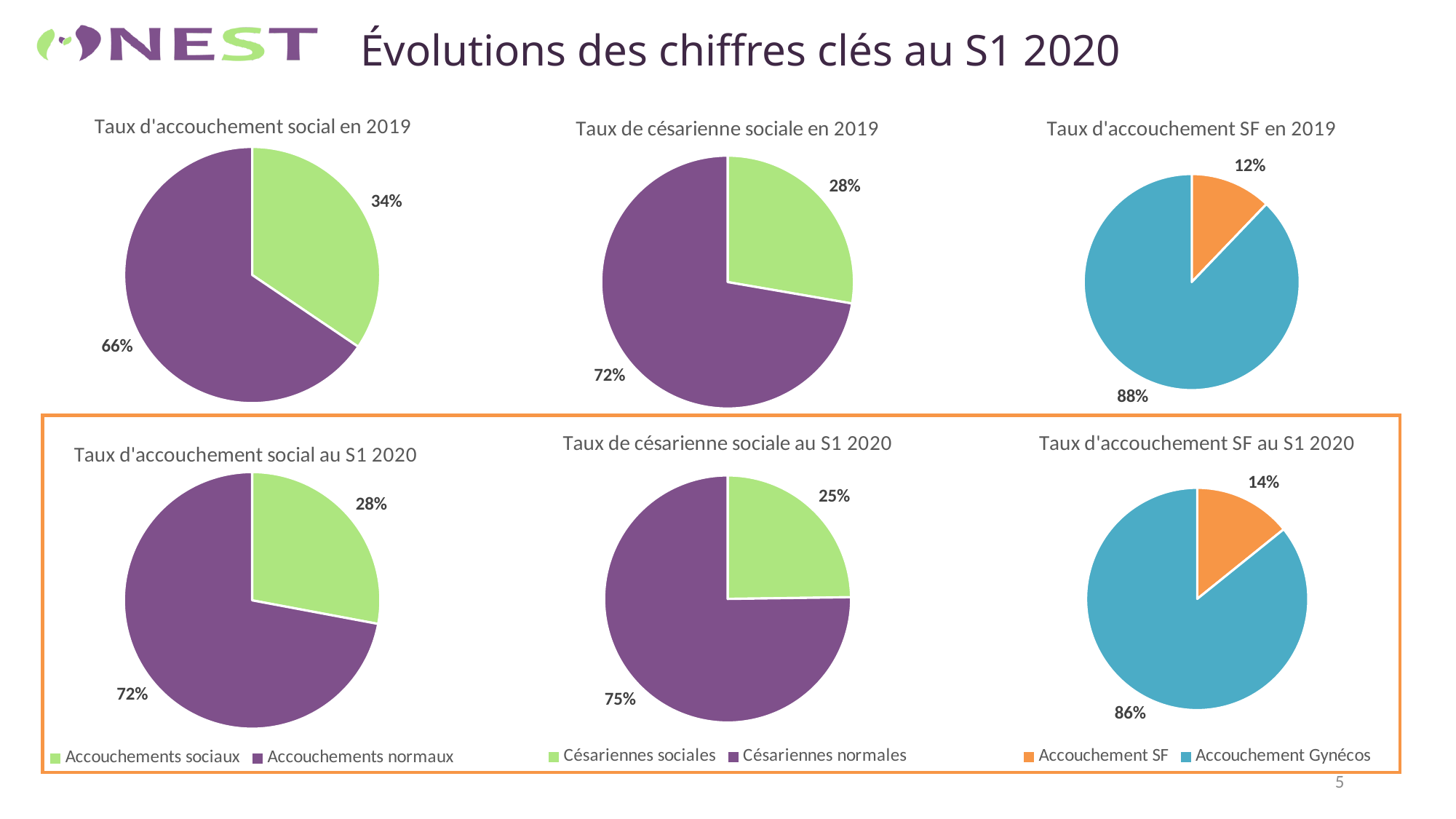
What is the difference between the Accouchements sociaux share in "Taux d'accouchement social en 2019" and in "Taux d'accouchement social au S1 2020"? 6% Which is larger: the Accouchement SF share in "Taux d'accouchement SF en 2019" or in "Taux d'accouchement SF au S1 2020"? Taux d'accouchement SF au S1 2020 What kind of chart is "Taux de césarienne sociale au S1 2020"? Pie chart In the chart titled "Taux d'accouchement SF au S1 2020", which slice is the largest? Accouchement Gynécos In the chart titled "Taux d'accouchement social en 2019", what is the value for Accouchements normaux? 66% In the chart titled "Taux d'accouchement SF en 2019", what share of the pie is Accouchement SF? 12% In the chart titled "Taux de césarienne sociale au S1 2020", what is the value for Césariennes normales? 75% In the chart titled "Taux d'accouchement social au S1 2020", what is the value for Accouchements sociaux? 28% In the chart titled "Taux de césarienne sociale en 2019", which slice is the smallest? Césariennes sociales In the chart titled "Taux d'accouchement SF au S1 2020", what is the value for Accouchement Gynécos? 86% In the chart titled "Taux de césarienne sociale en 2019", what is the value for Césariennes sociales? 28% In the chart titled "Taux d'accouchement social en 2019", what share of the pie is Accouchements sociaux? 34%